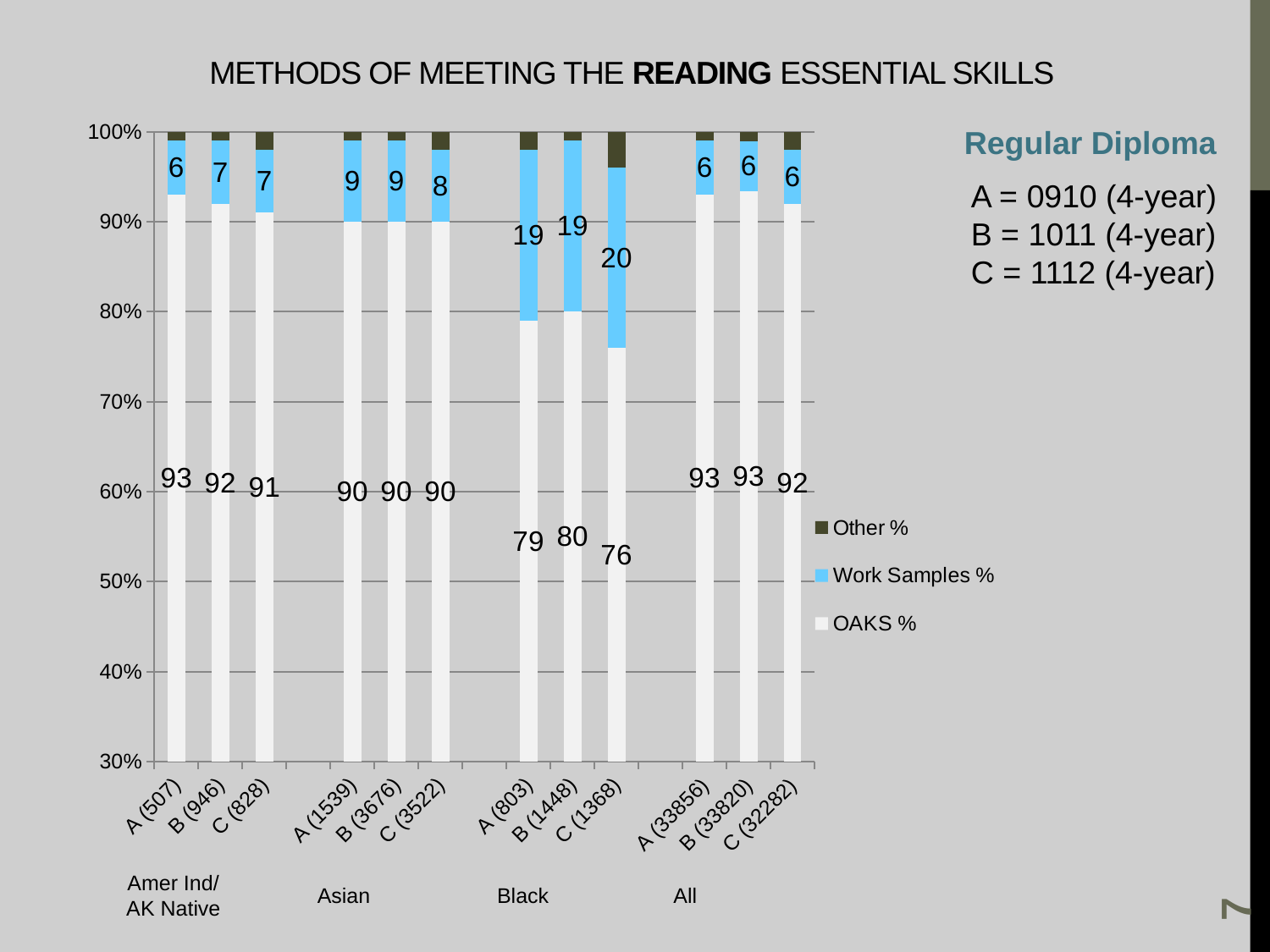
Which series is shown in light blue in the legend? Work Samples % Is the OAKS % value for Black C (1368) greater or less than 80%? less What is the OAKS % value for the Black A (803) bar? 79 Which is larger, the Work Samples % for Amer Ind/AK Native B (946) or for Asian B (3676)? Asian B (3676) What is the Work Samples % value for the Black C (1368) bar? 20 What is the OAKS % value for the All B (33820) bar? 93 How many series does the legend list? 3 How many bars are plotted in the chart? 12 Which group has the highest Work Samples % values? Black What is the difference between the OAKS % values for Asian A (1539) and Black A (803)? 11 Which bar has the lowest OAKS % value? C (1368) (Black) What type of chart is shown on the slide? stacked bar chart